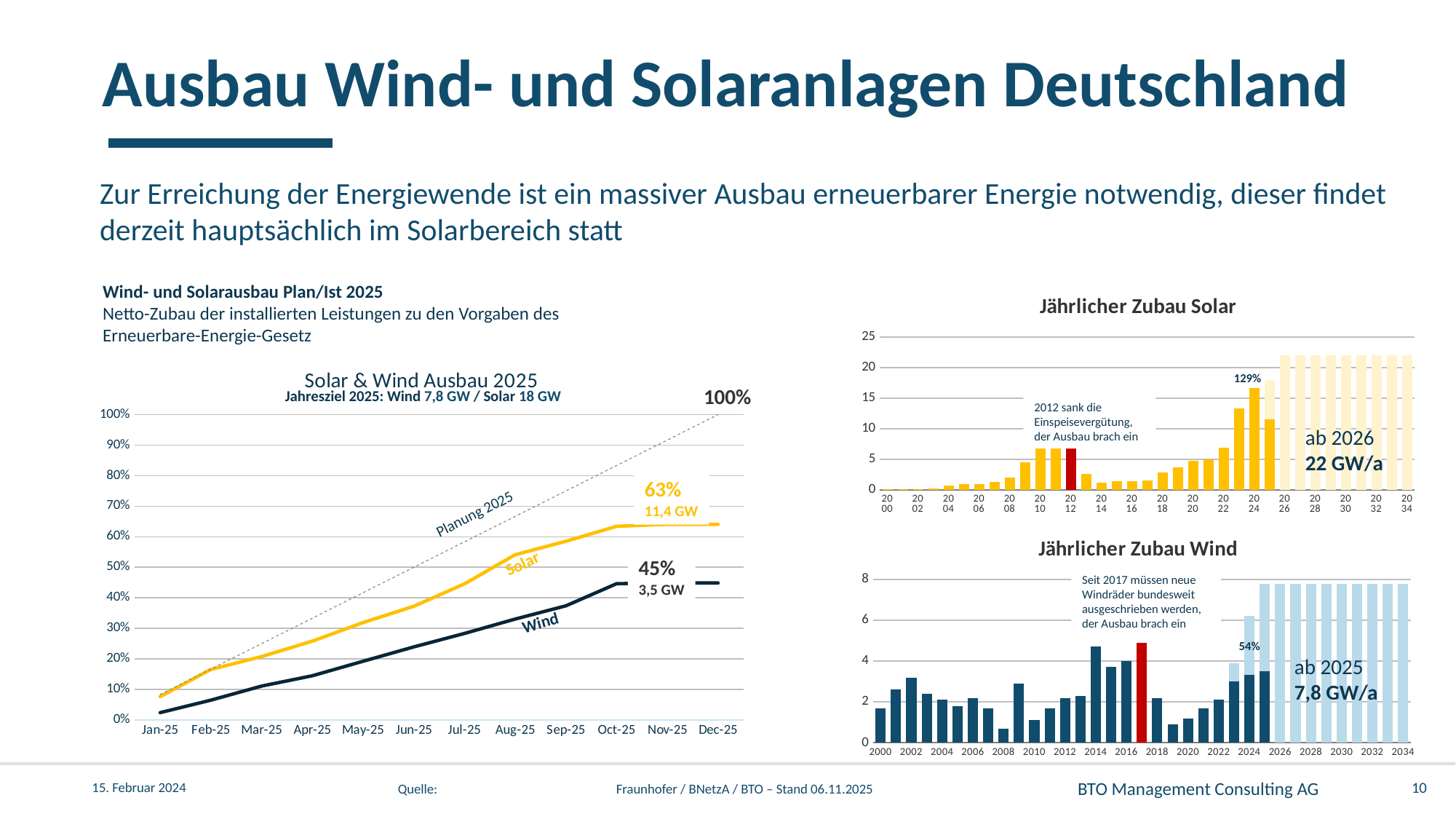
In the 'Solar & Wind Ausbau 2025' chart, what GW value is shown for Wind? 3,5 GW In the 'Solar & Wind Ausbau 2025' chart, which line ends higher, Solar or Wind? Solar In the 'Jährlicher Zubau Solar' chart, what annual addition is planned from 2026 onwards? 22 GW/a In the 'Solar & Wind Ausbau 2025' chart, what is the difference in percentage points between the Solar (63%) and Wind (45%) end values? 18 percentage points What kind of chart is 'Solar & Wind Ausbau 2025'? line chart How many months are shown on the x axis of the 'Solar & Wind Ausbau 2025' chart? 12 In the 'Solar & Wind Ausbau 2025' chart, what percentage of the annual target did Solar reach? 63% In the 'Jährlicher Zubau Wind' chart, is the value for 2014 greater or less than 4? greater In the 'Jährlicher Zubau Solar' chart, what percentage label is shown above the 2024 bar? 129% What kind of chart is 'Jährlicher Zubau Wind'? bar chart In the 'Jährlicher Zubau Solar' chart, is the value for 2024 greater or less than 15? greater In the 'Jährlicher Zubau Wind' chart, what annual addition is planned from 2025 onwards? 7,8 GW/a